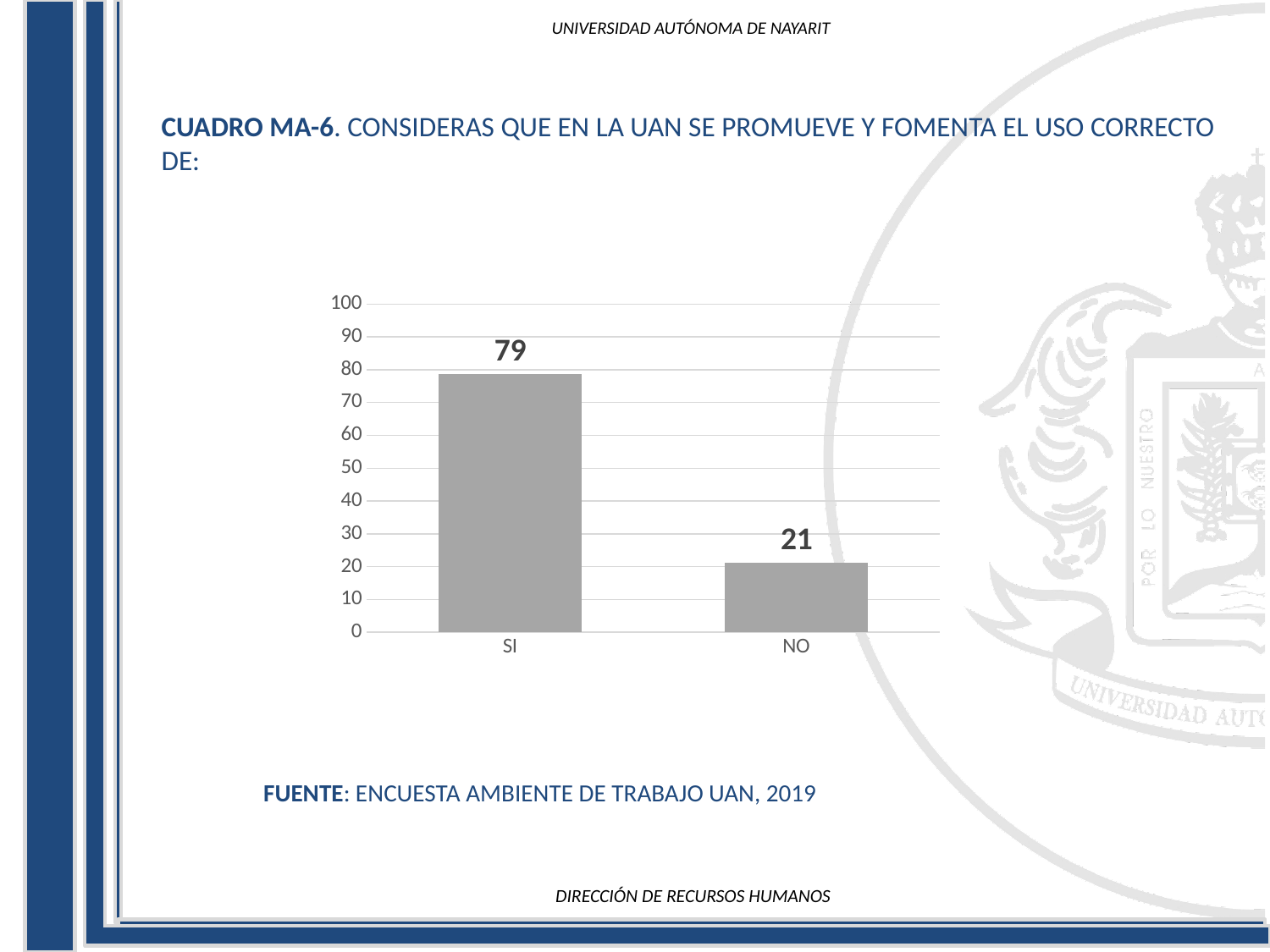
What is the difference between the values for SI and NO? 58 What is the value for NO? 21 What is the value for SI? 79 Which category has the highest value? SI Is the value for NO greater or less than 30? less How many categories are shown on the x axis? 2 What is the highest value shown on the y axis? 100 What is the total of the values for SI and NO? 100 Is the value for SI greater or less than 50? greater Which category has the lowest value? NO Which is larger, the value for SI or the value for NO? SI What kind of chart is shown on the slide? bar chart